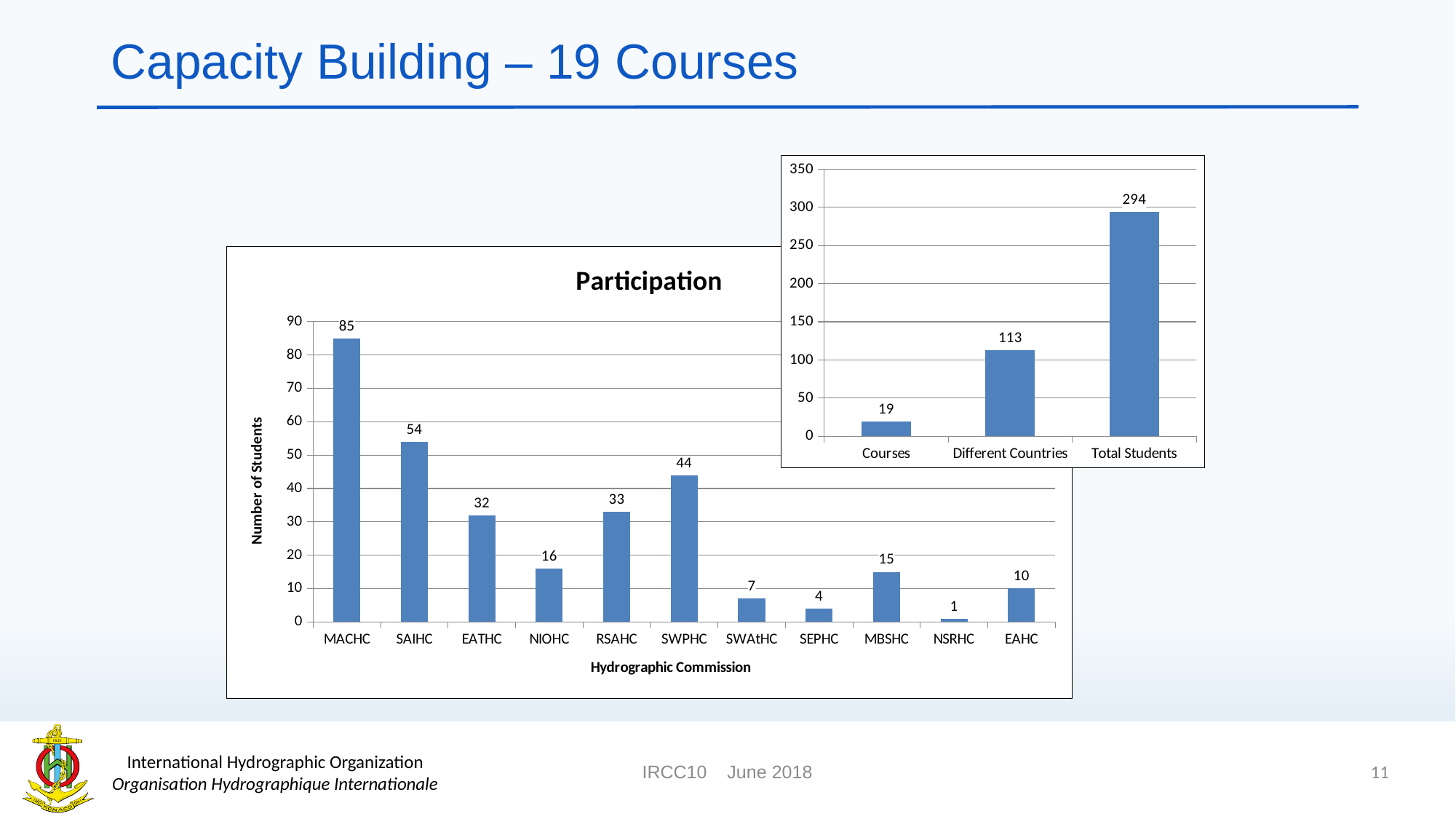
In the chart at the top right of the slide, what is the value for Total Students? 294 In the Participation chart, which hydrographic commission has the lowest number of students? NSRHC In the chart at the top right of the slide, what is the difference between Total Students and Different Countries? 181 In the Participation chart, what is the difference in number of students between SAIHC and SWPHC? 10 In the Participation chart, how many students are shown for MACHC? 85 What is the x-axis title of the Participation chart? Hydrographic Commission In the Participation chart, which hydrographic commission has the highest number of students? MACHC In the chart at the top right of the slide, what is the value for Different Countries? 113 In the Participation chart, what is the value for SEPHC? 4 What type of chart is the Participation chart? Bar chart In the Participation chart, which has more students, EATHC or RSAHC? RSAHC In the Participation chart, how many hydrographic commissions are shown on the x axis? 11